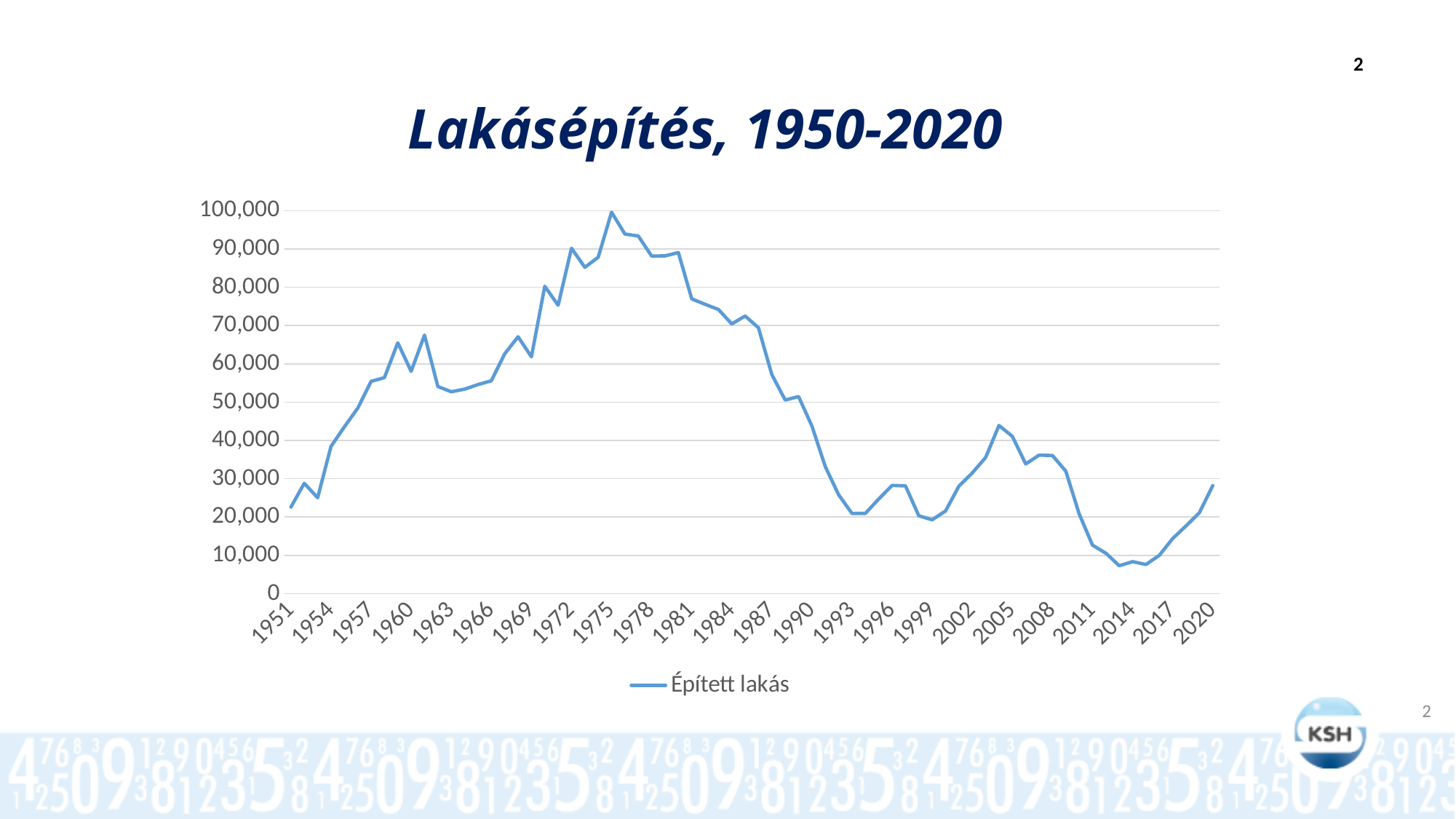
What kind of chart is shown on the slide? line chart Is the value for 1984 greater or less than 60,000? greater Does the line generally rise or fall between 1975 and 2014? fall Is the value for 1951 greater or less than 30,000? less In which year does the Épített lakás line reach its highest value? 1975 How many series does the legend list? 1 Which year has the larger value, 1975 or 2020? 1975 What is the name of the series shown in the legend? Épített lakás Is the value for 2014 greater or less than 10,000? less What is the title of the chart? Lakásépítés, 1950-2020